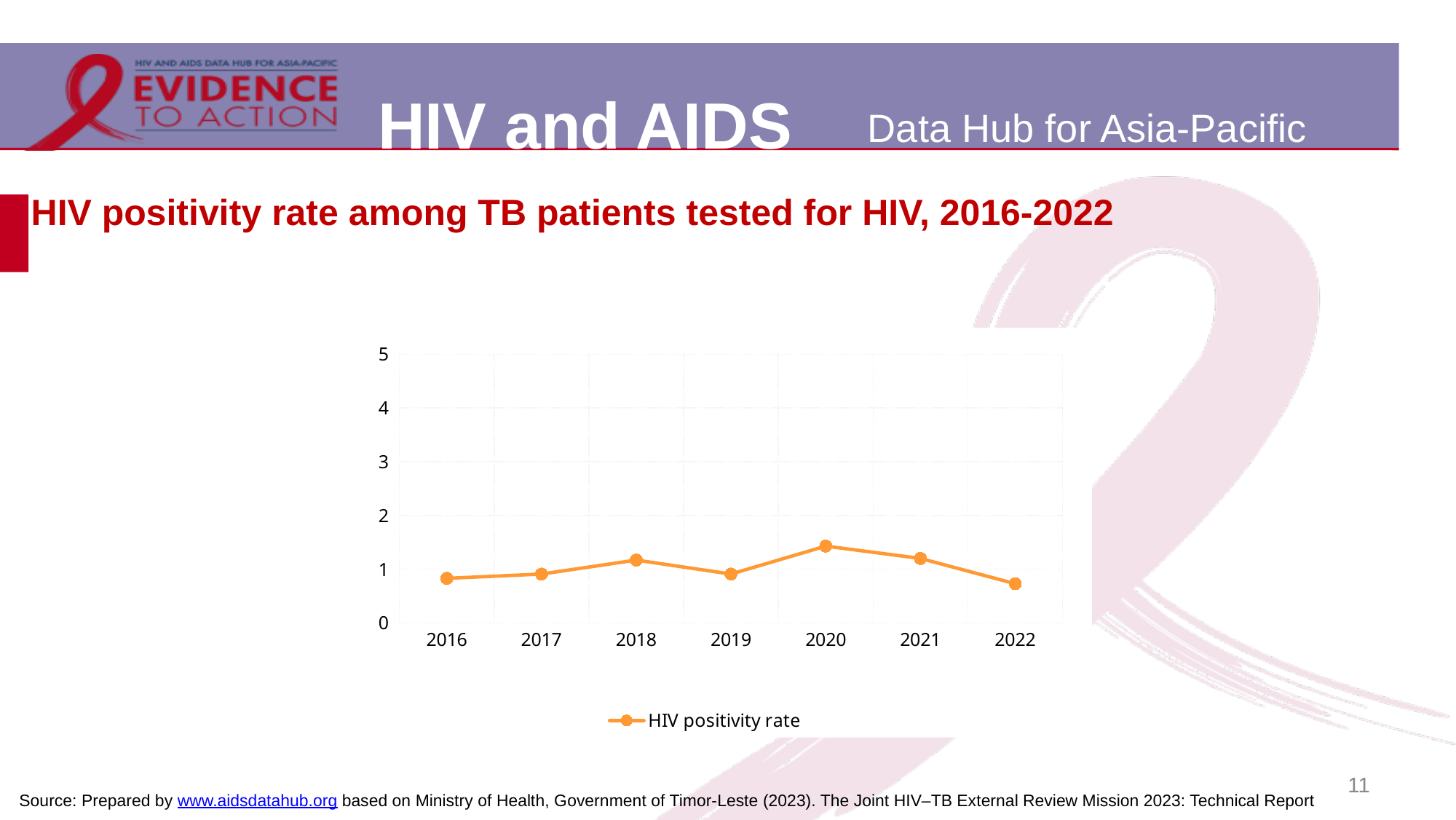
Is the HIV positivity rate for 2020 greater or less than 1? greater How many series does the chart legend list? 1 Is the HIV positivity rate for 2022 greater or less than 1? less Does the HIV positivity rate rise or fall from 2020 to 2022? fall Is the HIV positivity rate for 2016 greater or less than 1? less Which year has the larger HIV positivity rate, 2018 or 2019? 2018 What is the title of the chart on the slide? HIV positivity rate among TB patients tested for HIV, 2016-2022 What kind of chart is shown on the slide? line chart In which year was the HIV positivity rate highest? 2020 What is the series name shown in the chart legend? HIV positivity rate How many years are plotted on the x axis of the chart? 7